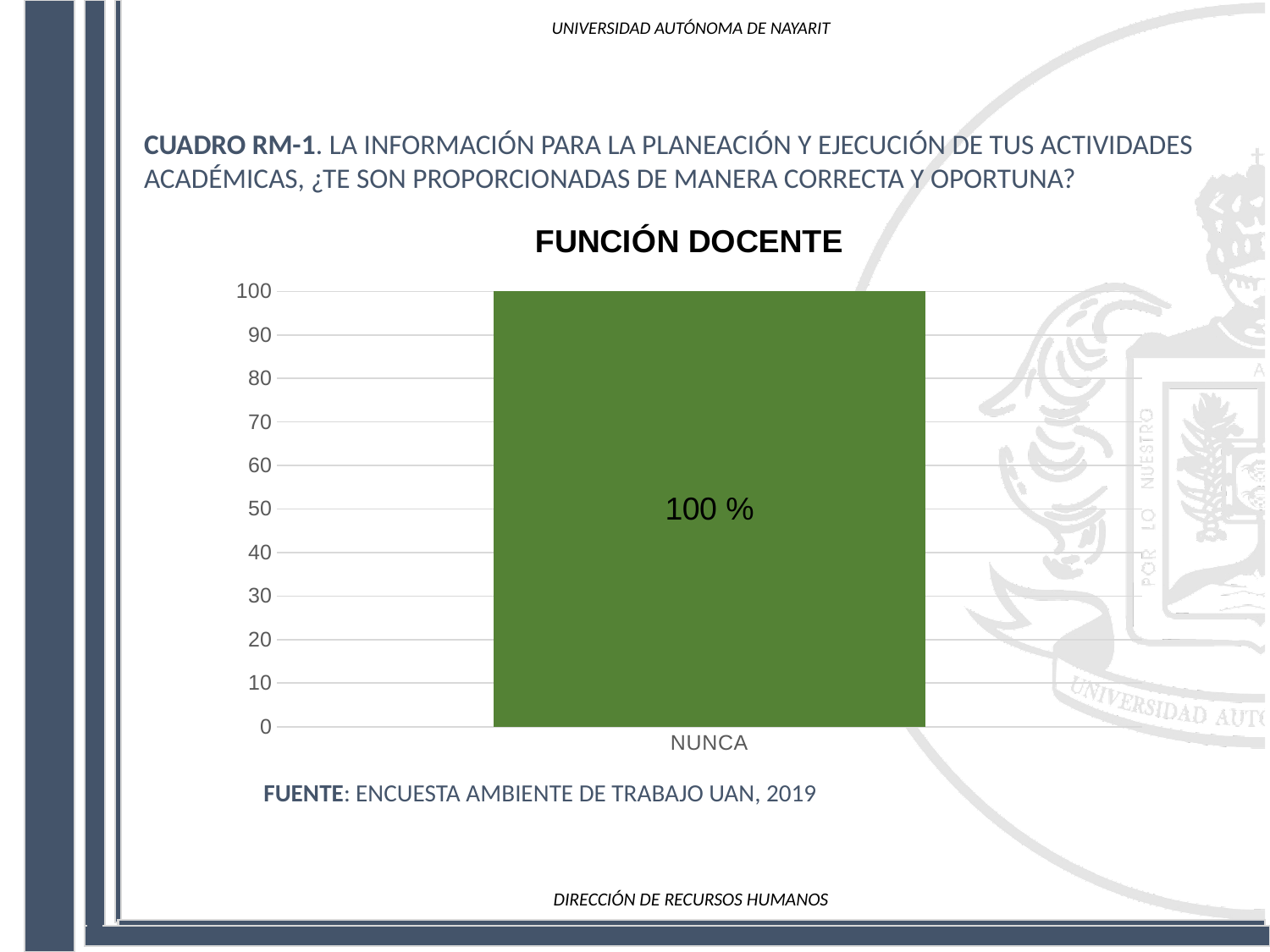
What is the label of the only category on the x axis? NUNCA What kind of chart is shown on the slide? bar chart What is the maximum value shown on the y axis? 100 How many categories are plotted on the x axis? 1 Is the value for NUNCA greater or less than 50? greater What is the value for NUNCA? 100 % What is the title of the chart? FUNCIÓN DOCENTE